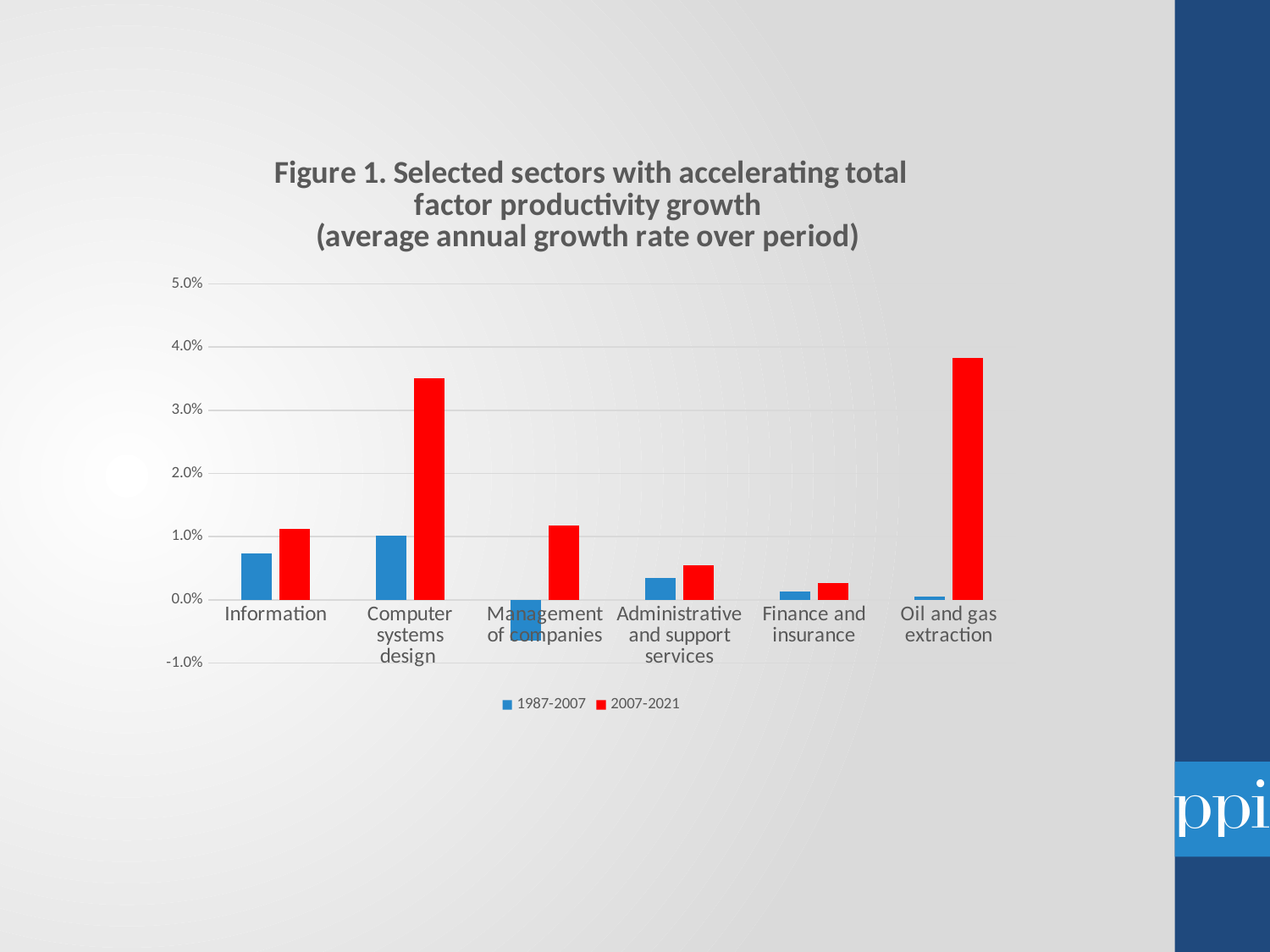
Which sector has the highest value for the 1987-2007 series? Computer systems design Is the 2007-2021 value for Finance and insurance greater or less than 1.0%? less Is the 1987-2007 value for Management of companies greater or less than 0.0%? less For Oil and gas extraction, which series has the larger value, 1987-2007 or 2007-2021? 2007-2021 Which sector has the lowest value for the 1987-2007 series? Management of companies How many sectors are shown on the x axis of the chart? 6 How many series does the chart's legend list? 2 Is the 2007-2021 value for Computer systems design greater or less than 3.0%? greater Which sector has the highest value for the 2007-2021 series? Oil and gas extraction Which colour represents the 2007-2021 series in the chart? red Which is larger: the 2007-2021 value for Information or the 2007-2021 value for Computer systems design? Computer systems design What kind of chart is shown on the slide? bar chart